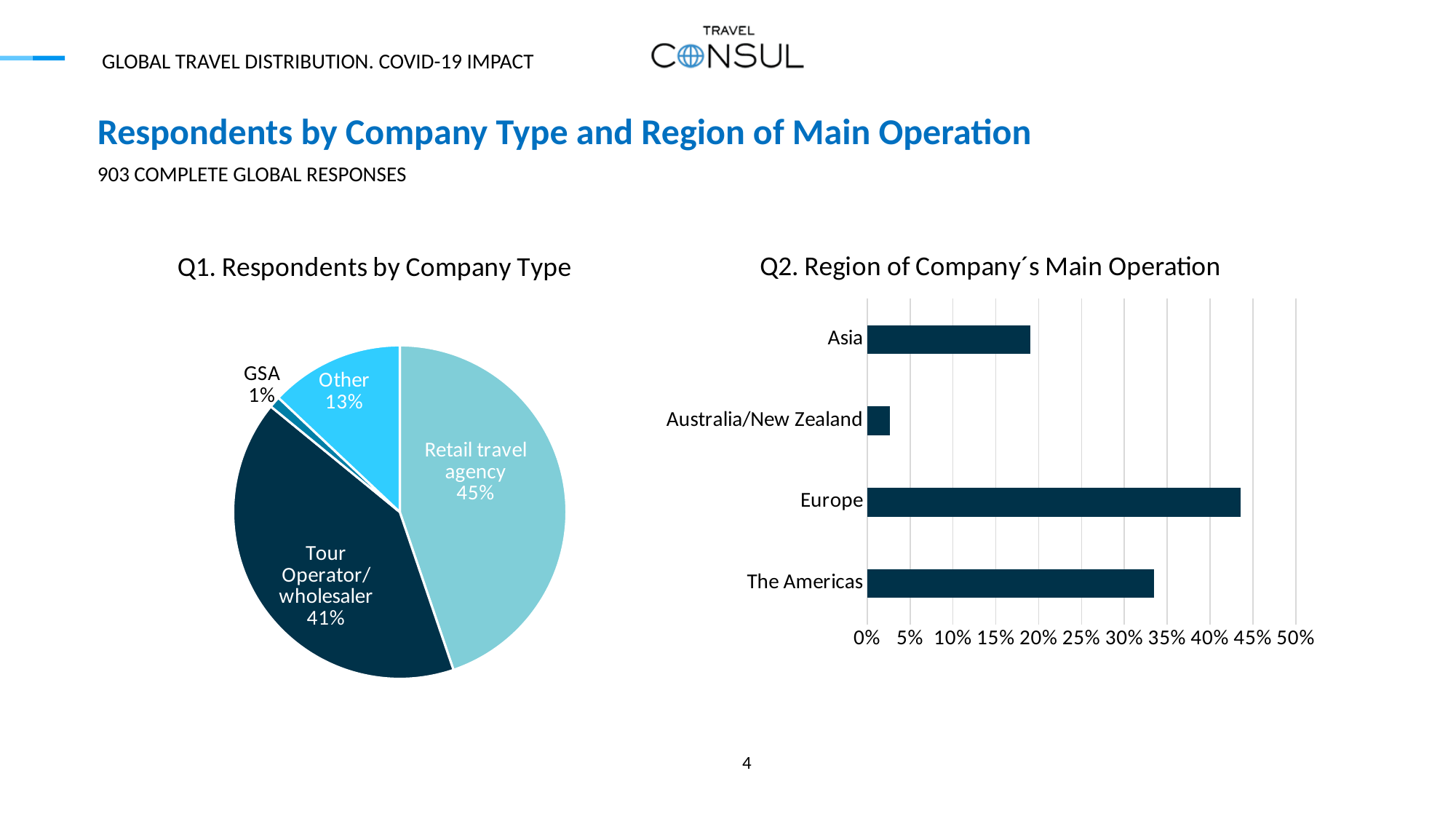
In the 'Q1. Respondents by Company Type' chart, what share of respondents are tour operators/wholesalers? 41% In the 'Q2. Region of Company´s Main Operation' chart, is the value for Asia greater or less than 15%? greater In the 'Q1. Respondents by Company Type' chart, how many percentage points larger is the Retail travel agency share than the Other share? 32 In the 'Q1. Respondents by Company Type' chart, what share of respondents are retail travel agencies? 45% In the 'Q2. Region of Company´s Main Operation' chart, which is larger, the value for The Americas or the value for Asia? The Americas What kind of chart is 'Q2. Region of Company´s Main Operation'? Bar chart In the 'Q2. Region of Company´s Main Operation' chart, which region has the highest value? Europe In the 'Q1. Respondents by Company Type' chart, what share is labelled 'Other'? 13% How many slices does the 'Q1. Respondents by Company Type' pie chart have? 4 In the 'Q1. Respondents by Company Type' chart, which company type has the smallest share? GSA In the 'Q2. Region of Company´s Main Operation' chart, which region has the lowest value? Australia/New Zealand In the 'Q1. Respondents by Company Type' chart, which company type has the largest share? Retail travel agency